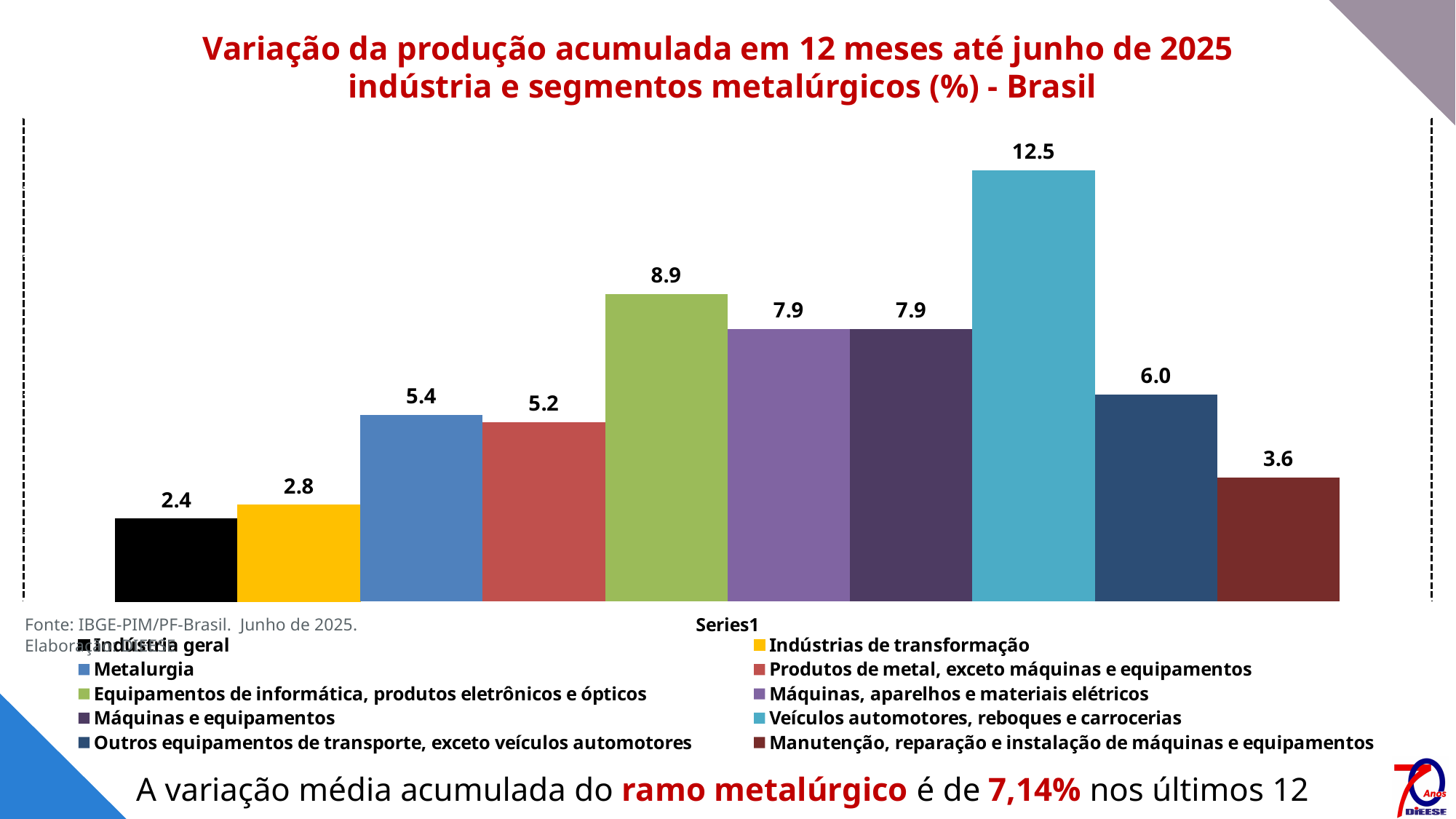
What colour is the bar for Indústrias de transformação? Yellow What is the value for Manutenção, reparação e instalação de máquinas e equipamentos? 3.6 What is the value for Metalurgia? 5.4 What is the value for Veículos automotores, reboques e carrocerias? 12.5 What kind of chart is shown on the slide? Bar chart What is the value for Equipamentos de informática, produtos eletrônicos e ópticos? 8.9 Which segment has the highest value? Veículos automotores, reboques e carrocerias Which category has the lowest value? Indústria geral How many bars are plotted in the chart? 10 What is the difference between the values for Veículos automotores, reboques e carrocerias and Indústria geral? 10.1 Which is larger, the value for Metalurgia or the value for Produtos de metal, exceto máquinas e equipamentos? Metalurgia How many entries does the legend list? 10